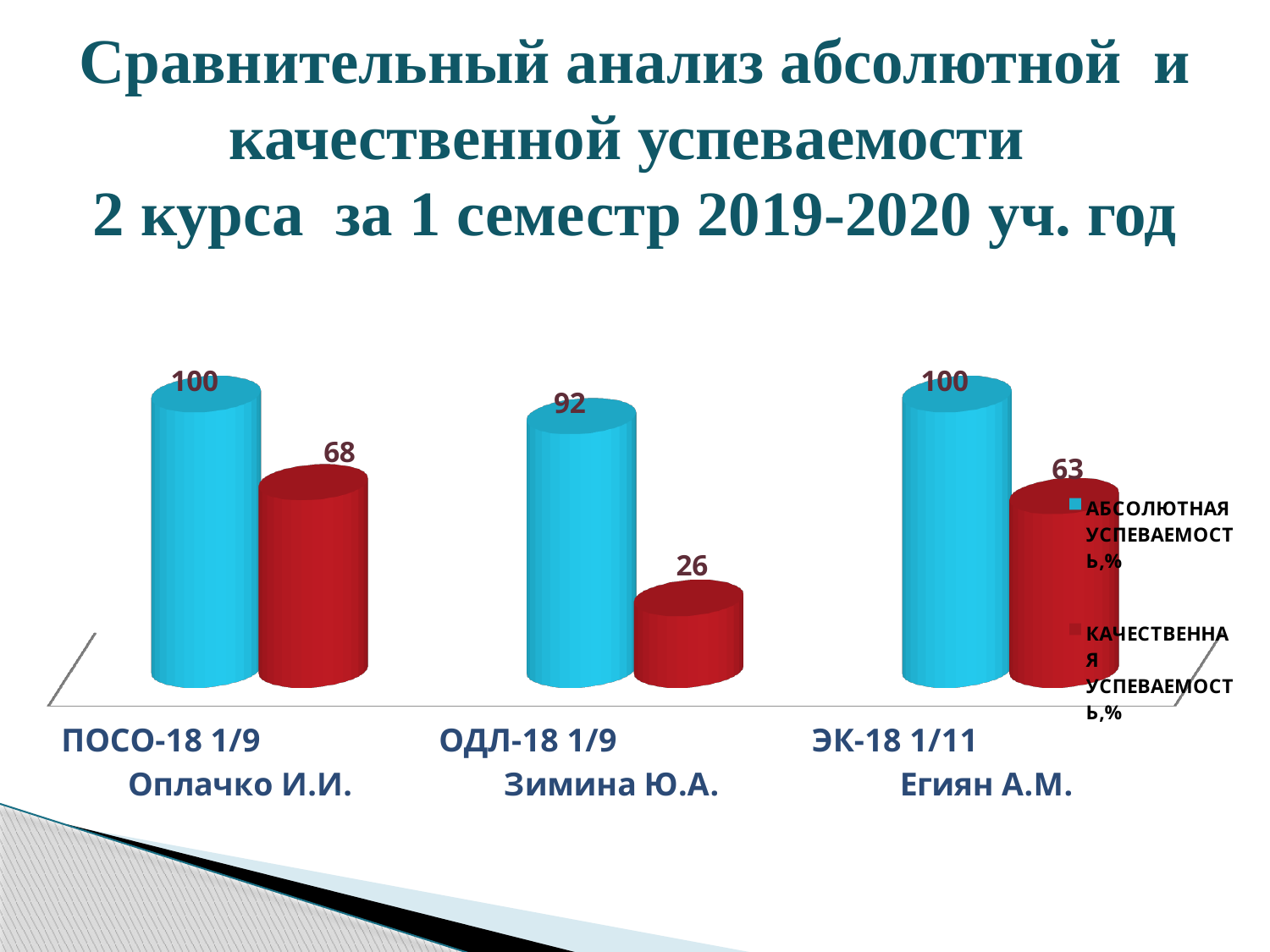
Which is larger: the qualitative performance of ПОСО-18 1/9 Оплачко И.И. or of ЭК-18 1/11 Егиян А.М.? ПОСО-18 1/9 Оплачко И.И. What is the qualitative performance (КАЧЕСТВЕННАЯ УСПЕВАЕМОСТЬ,%) value for ЭК-18 1/11 Егиян А.М.? 63 How many series does the legend list? 2 What is the absolute performance (АБСОЛЮТНАЯ УСПЕВАЕМОСТЬ,%) value for ОДЛ-18 1/9 Зимина Ю.А.? 92 What is the qualitative performance (КАЧЕСТВЕННАЯ УСПЕВАЕМОСТЬ,%) value for ПОСО-18 1/9 Оплачко И.И.? 68 What is the difference between the qualitative performance values of ПОСО-18 1/9 Оплачко И.И. and ЭК-18 1/11 Егиян А.М.? 5 What is the absolute performance (АБСОЛЮТНАЯ УСПЕВАЕМОСТЬ,%) value for ЭК-18 1/11 Егиян А.М.? 100 Which group has the lowest qualitative performance (КАЧЕСТВЕННАЯ УСПЕВАЕМОСТЬ,%)? ОДЛ-18 1/9 Зимина Ю.А. Which group has the highest qualitative performance (КАЧЕСТВЕННАЯ УСПЕВАЕМОСТЬ,%)? ПОСО-18 1/9 Оплачко И.И. What is the difference between the absolute and qualitative performance values for ОДЛ-18 1/9 Зимина Ю.А.? 66 Which group has the lowest absolute performance (АБСОЛЮТНАЯ УСПЕВАЕМОСТЬ,%)? ОДЛ-18 1/9 Зимина Ю.А. How many groups (categories) are shown on the chart? 3